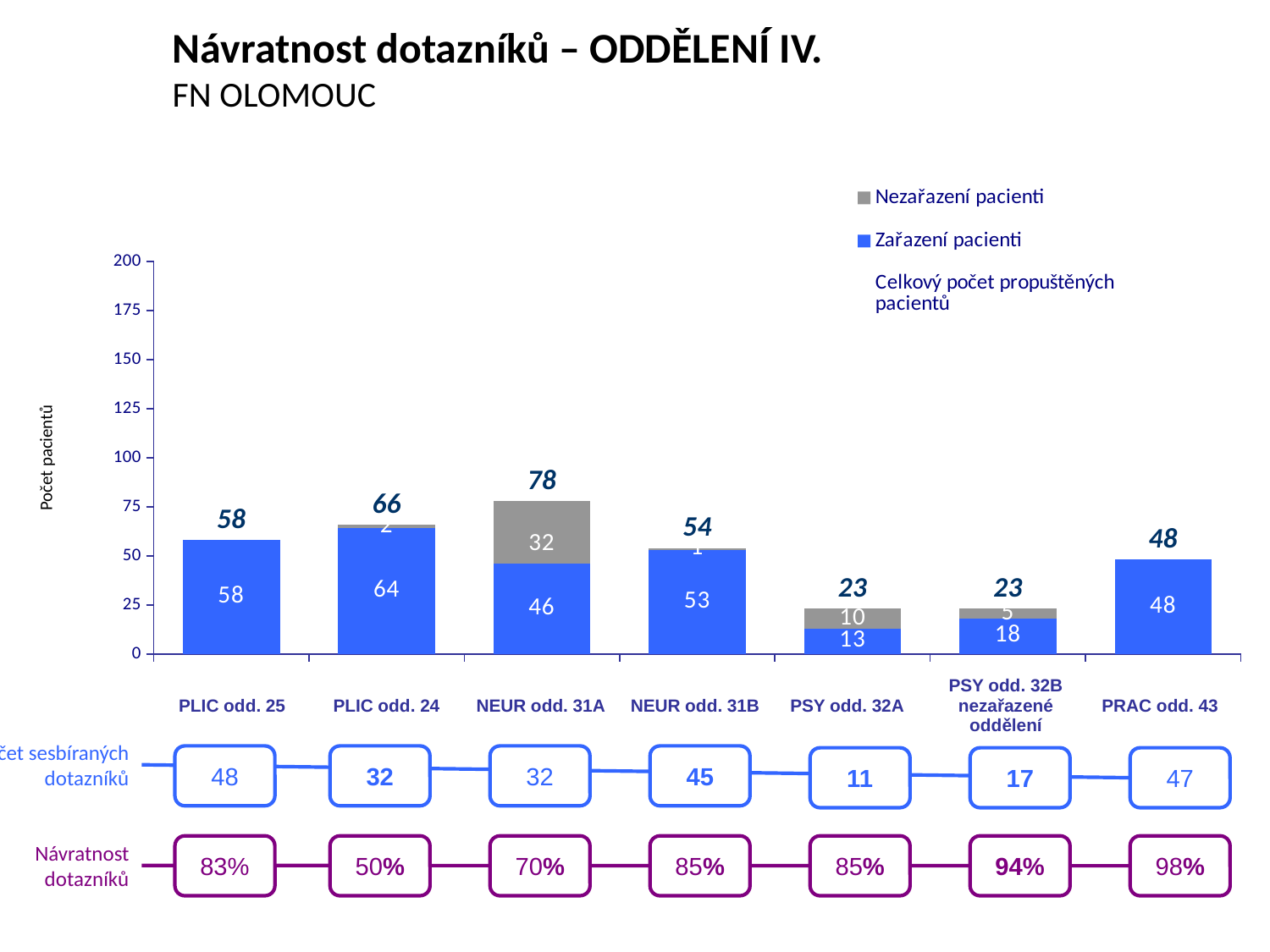
What is the difference between the Zařazení pacienti values for PLIC odd. 24 and PRAC odd. 43? 16 What is the total number of patients (Celkový počet propuštěných pacientů) shown above the bar for PLIC odd. 24? 66 Which department has the lowest value of Zařazení pacienti? PSY odd. 32A How many entries does the chart legend list? 3 What is the label of the y axis of the chart? Počet pacientů Is the total for NEUR odd. 31A greater or less than 75? greater Which is larger, the Zařazení pacienti value for NEUR odd. 31B or for PLIC odd. 25? PLIC odd. 25 What is the value of Zařazení pacienti for NEUR odd. 31A? 46 How many departments (categories) are shown on the x axis of the chart? 7 Which department has the highest total number of discharged patients? NEUR odd. 31A What type of chart is shown on the slide? Stacked bar chart What is the value of Nezařazení pacienti for PSY odd. 32A? 10